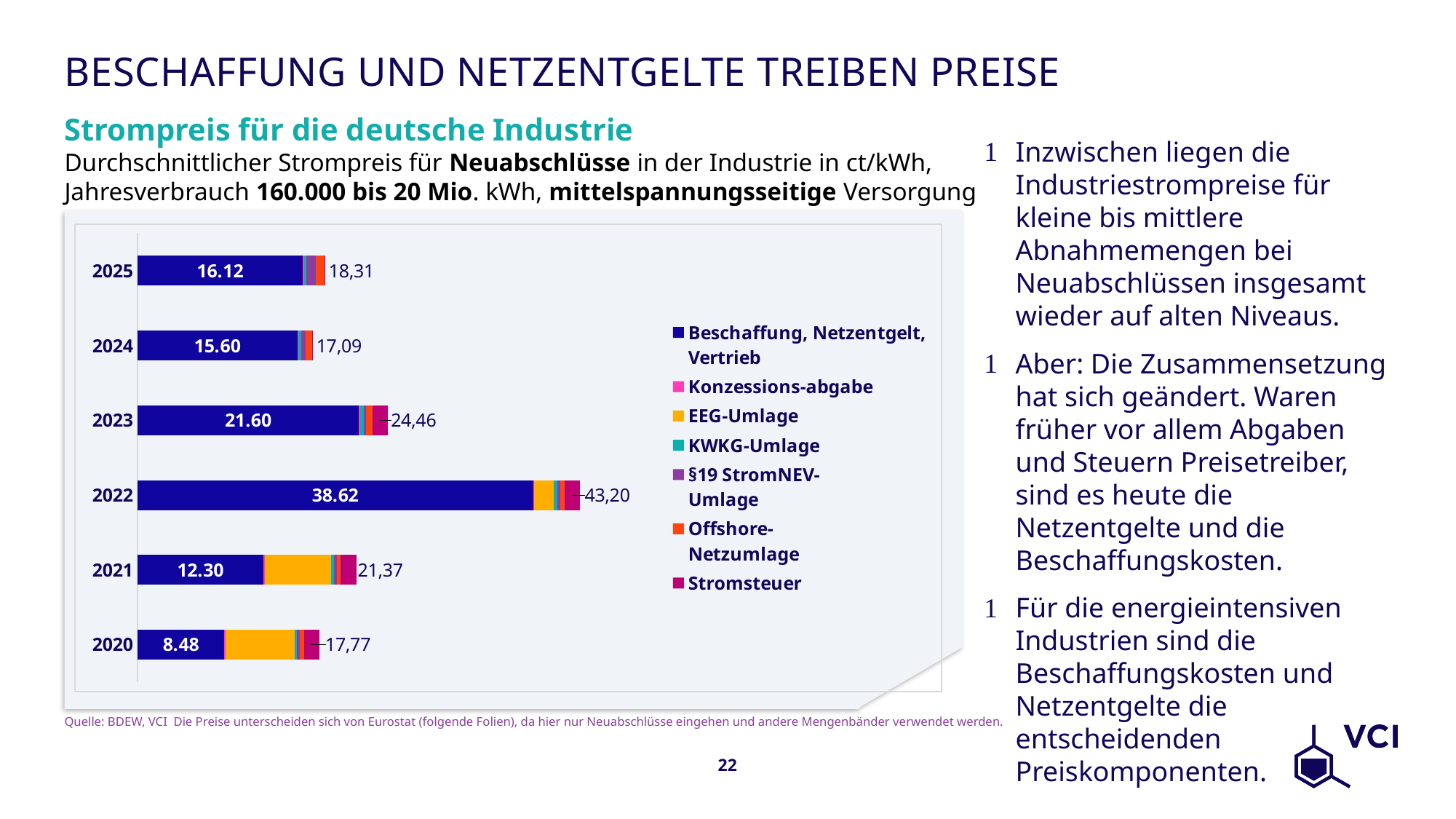
What is the value of the 'Beschaffung, Netzentgelt, Vertrieb' segment for 2021? 12.30 What is the difference between the total price for 2022 and the total price for 2023? 18,74 What is the value of the 'Beschaffung, Netzentgelt, Vertrieb' segment for 2022? 38.62 How many years are shown in the chart? 6 What is the total electricity price shown for 2020? 17,77 Which year has the lowest 'Beschaffung, Netzentgelt, Vertrieb' value? 2020 Which year has the highest total electricity price? 2022 Is the total price for 2024 larger or smaller than the total price for 2021? smaller What kind of chart is shown on the slide? stacked bar chart Which legend entry is shown in orange? EEG-Umlage How many series does the legend list? 7 What is the total electricity price shown for 2025? 18,31